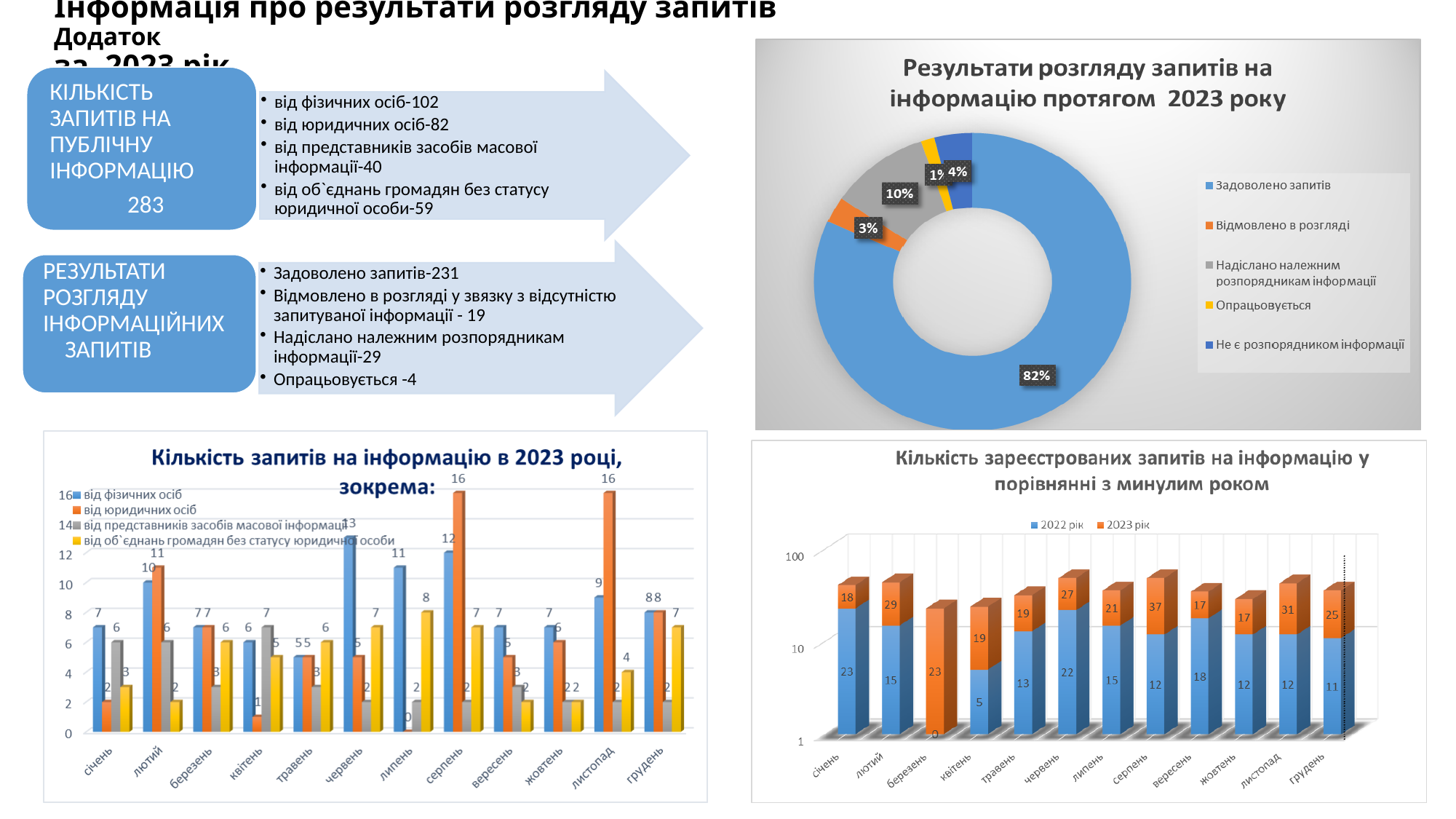
In the chart 'Кількість запитів на інформацію в 2023 році, зокрема:', what is the value for 'від юридичних осіб' in серпень? 16 In the chart 'Кількість зареєстрованих запитів на інформацію у порівнянні з минулим роком', which is larger in вересень: '2022 рік' or '2023 рік'? 2022 рік In the chart 'Кількість зареєстрованих запитів на інформацію у порівнянні з минулим роком', what is the total of the stacked bar for січень? 41 In the chart 'Кількість зареєстрованих запитів на інформацію у порівнянні з минулим роком', in which month is the value for '2022 рік' lowest? березень What kind of chart is 'Кількість запитів на інформацію в 2023 році, зокрема:'? bar chart In the donut chart 'Результати розгляду запитів на інформацію протягом 2023 року', what share is labelled for 'Задоволено запитів'? 82% In the chart 'Кількість запитів на інформацію в 2023 році, зокрема:', what is the difference between 'від фізичних осіб' and 'від юридичних осіб' in січень? 5 In the chart 'Кількість запитів на інформацію в 2023 році, зокрема:', in which month is the value for 'від фізичних осіб' highest? червень In the chart 'Кількість запитів на інформацію в 2023 році, зокрема:', how many months are shown on the x axis? 12 In the chart 'Кількість зареєстрованих запитів на інформацію у порівнянні з минулим роком', what is the value for '2023 рік' in серпень? 37 In the donut chart 'Результати розгляду запитів на інформацію протягом 2023 року', which category has the smallest share? Опрацьовується In the donut chart 'Результати розгляду запитів на інформацію протягом 2023 року', how many entries does the legend list? 5